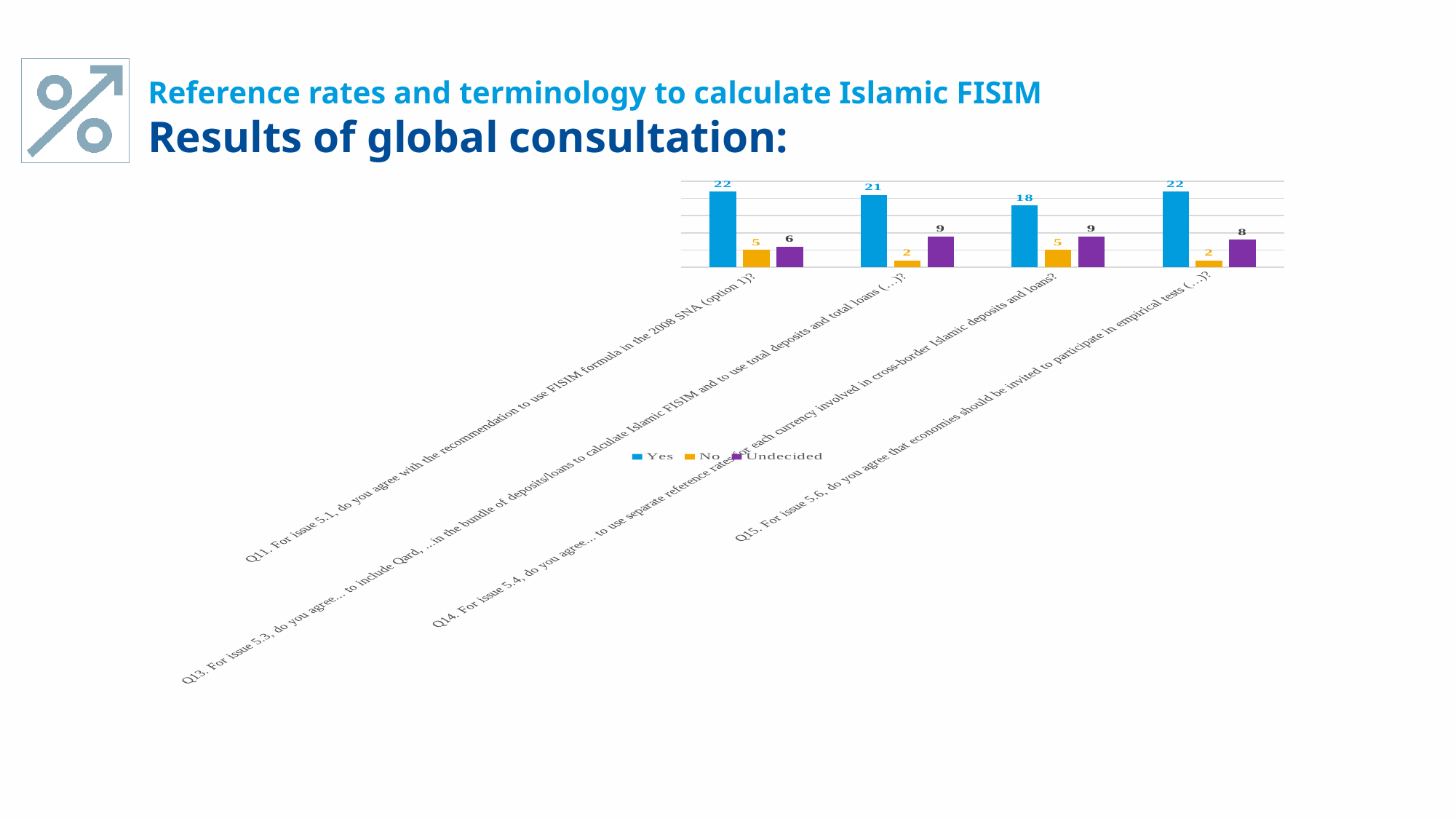
What is the 'Yes' value for Q14? 18 What are the three legend entries of the chart? Yes, No, Undecided How many questions (categories) are shown on the x axis? 4 What is the 'Undecided' value for Q14? 9 How many series does the legend list? 3 What is the 'Undecided' value for Q15? 8 What is the difference between the 'Yes' and 'No' values for Q13? 19 Which question has the lowest 'Yes' value? Q14 What kind of chart is shown on the slide? Bar chart What is the 'Yes' value for Q11? 22 What is the 'No' value for Q13? 2 Which is larger for Q11: the 'No' value or the 'Undecided' value? Undecided